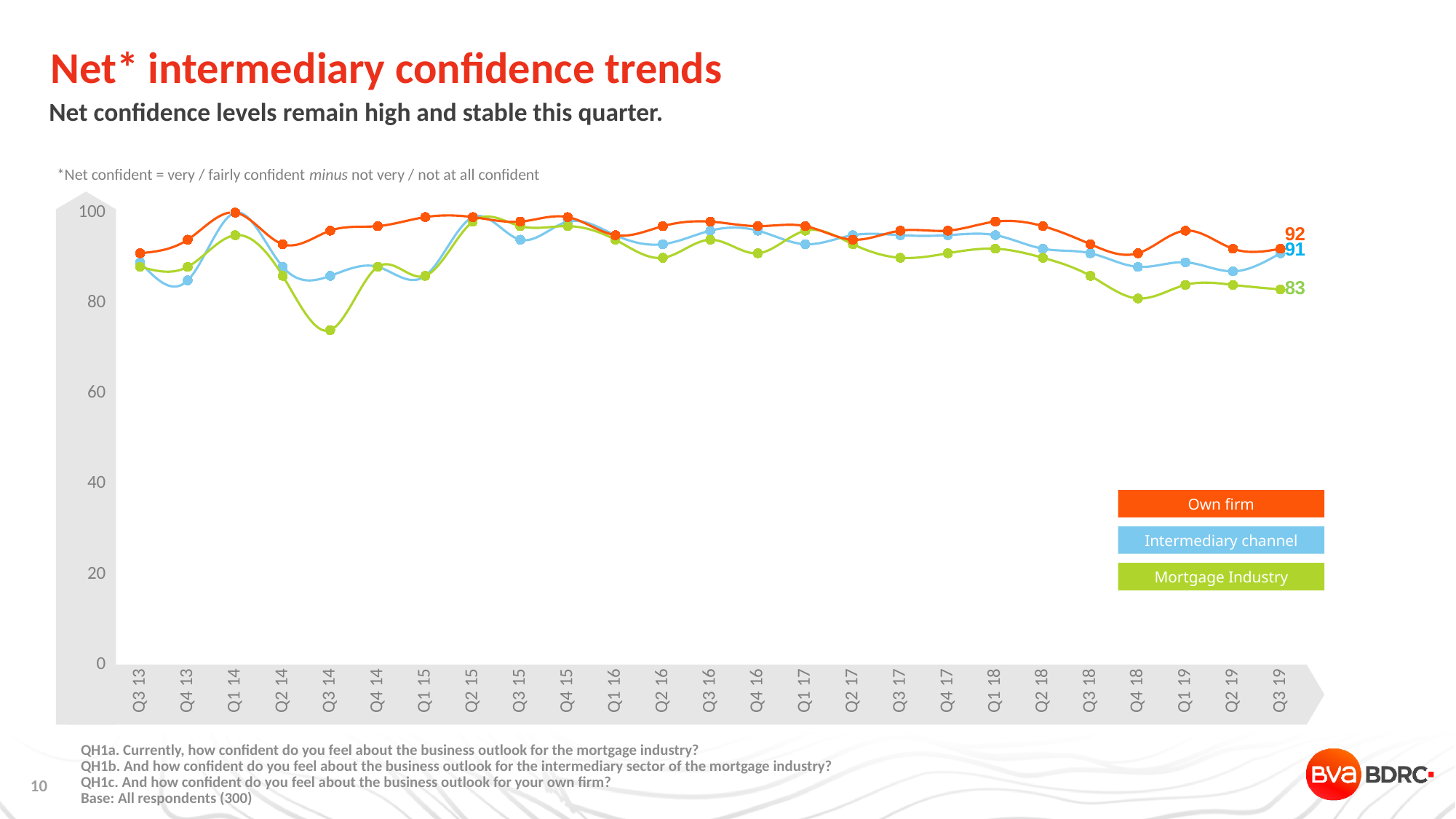
What is the difference between the Intermediary channel and Mortgage Industry values for Q3 19? 8 What is the Intermediary channel value for Q3 19? 91 In which quarter does the Mortgage Industry series reach its lowest point? Q3 14 Is the Own firm value for Q3 14 greater or less than 80? greater Is the Mortgage Industry value for Q3 14 greater or less than 80? less What is the Own firm value for Q3 19? 92 What is the difference between the Own firm and Mortgage Industry values for Q3 19? 9 Which series has the lowest value at Q3 19? Mortgage Industry How many series does the legend list? 3 Which is larger at Q3 19, the Own firm value or the Mortgage Industry value? Own firm What kind of chart is shown on the slide? Line chart What is the Mortgage Industry value for Q3 19? 83